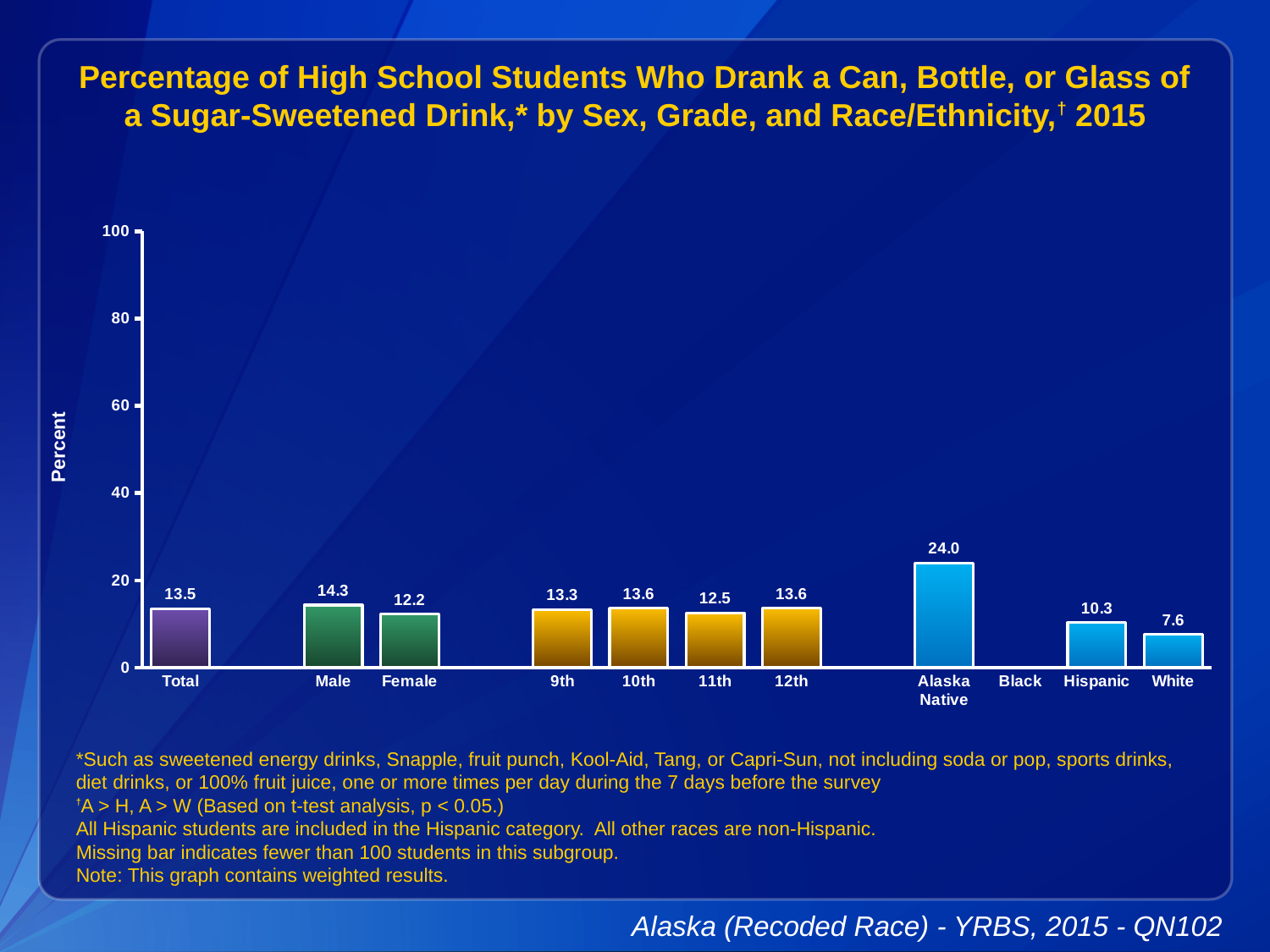
Which is larger, the value for 10th or the value for 11th? 10th How many bars are plotted on the chart? 11 What is the value for Total? 13.5 What is the value for Female? 12.2 What kind of chart is shown on the slide? bar chart What is the value for Alaska Native? 24.0 Which race/ethnicity category has no bar shown? Black Which category has the highest value? Alaska Native What is the difference between the values for Male and Female? 2.1 Is the value for Alaska Native greater or less than 20? greater What is the difference between the values for Alaska Native and White? 16.4 Which category has the lowest value among the bars shown? White